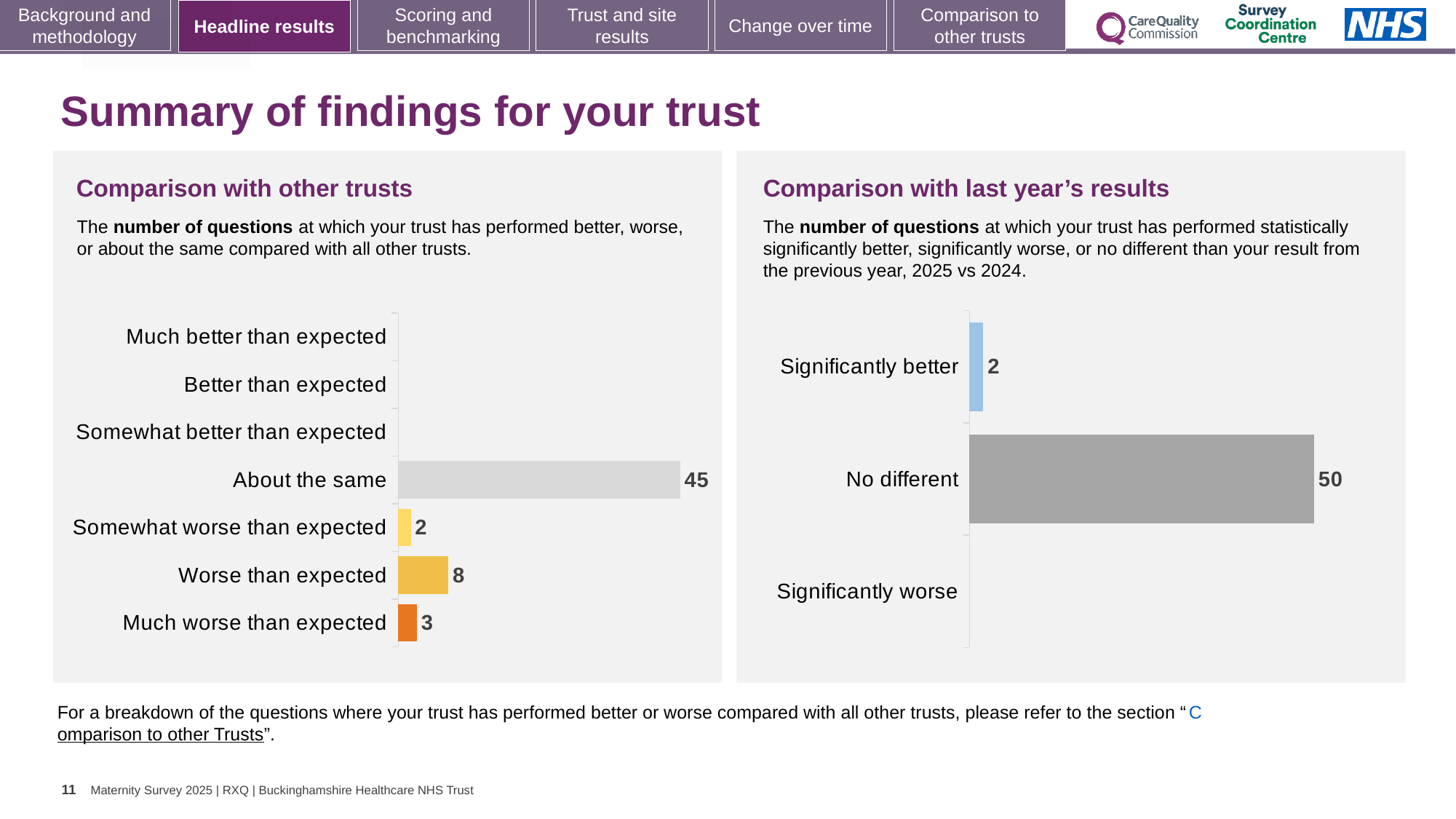
What kind of chart is the 'Comparison with last year's results' chart? Bar chart In the 'Comparison with other trusts' chart, which is larger: 'Worse than expected' or 'Much worse than expected'? Worse than expected In the 'Comparison with other trusts' chart, what is the difference between 'Worse than expected' and 'Somewhat worse than expected'? 6 In the 'Comparison with other trusts' chart, what is the value for 'Worse than expected'? 8 How many categories are listed in the 'Comparison with other trusts' chart? 7 In the 'Comparison with other trusts' chart, what is the value for 'About the same'? 45 In the 'Comparison with other trusts' chart, which category has the highest value? About the same In the 'Comparison with last year's results' chart, what is the difference between 'No different' and 'Significantly better'? 48 In the 'Comparison with other trusts' chart, what is the value for 'Much worse than expected'? 3 How many categories are listed in the 'Comparison with last year's results' chart? 3 In the 'Comparison with last year's results' chart, what is the value for 'Significantly better'? 2 In the 'Comparison with last year's results' chart, what is the value for 'No different'? 50